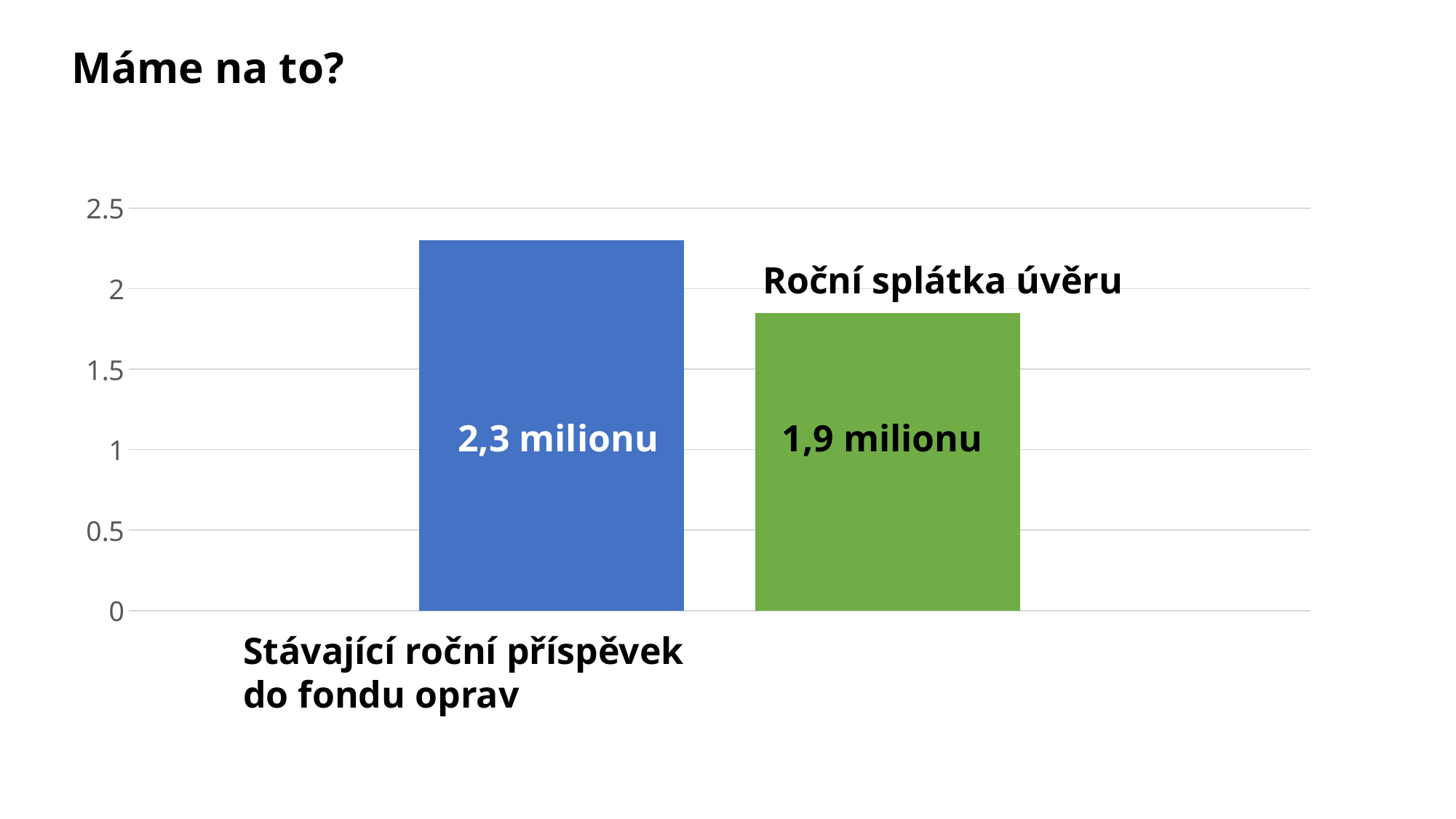
Which category has the lowest value? Roční splátka úvěru Which category has the highest value? Stávající roční příspěvek do fondu oprav What kind of chart is shown on the slide? bar chart What is the difference between "Stávající roční příspěvek do fondu oprav" and "Roční splátka úvěru"? 0,4 milionu What colour is the bar for "Roční splátka úvěru"? green What is the value for "Stávající roční příspěvek do fondu oprav"? 2,3 milionu How many bars are shown in the chart? 2 What is the value for "Roční splátka úvěru"? 1,9 milionu Is the value for "Roční splátka úvěru" greater or less than 2? less Which is larger: "Stávající roční příspěvek do fondu oprav" or "Roční splátka úvěru"? Stávající roční příspěvek do fondu oprav What is the title of the slide? Máme na to? Is the value for "Stávající roční příspěvek do fondu oprav" greater or less than 2? greater